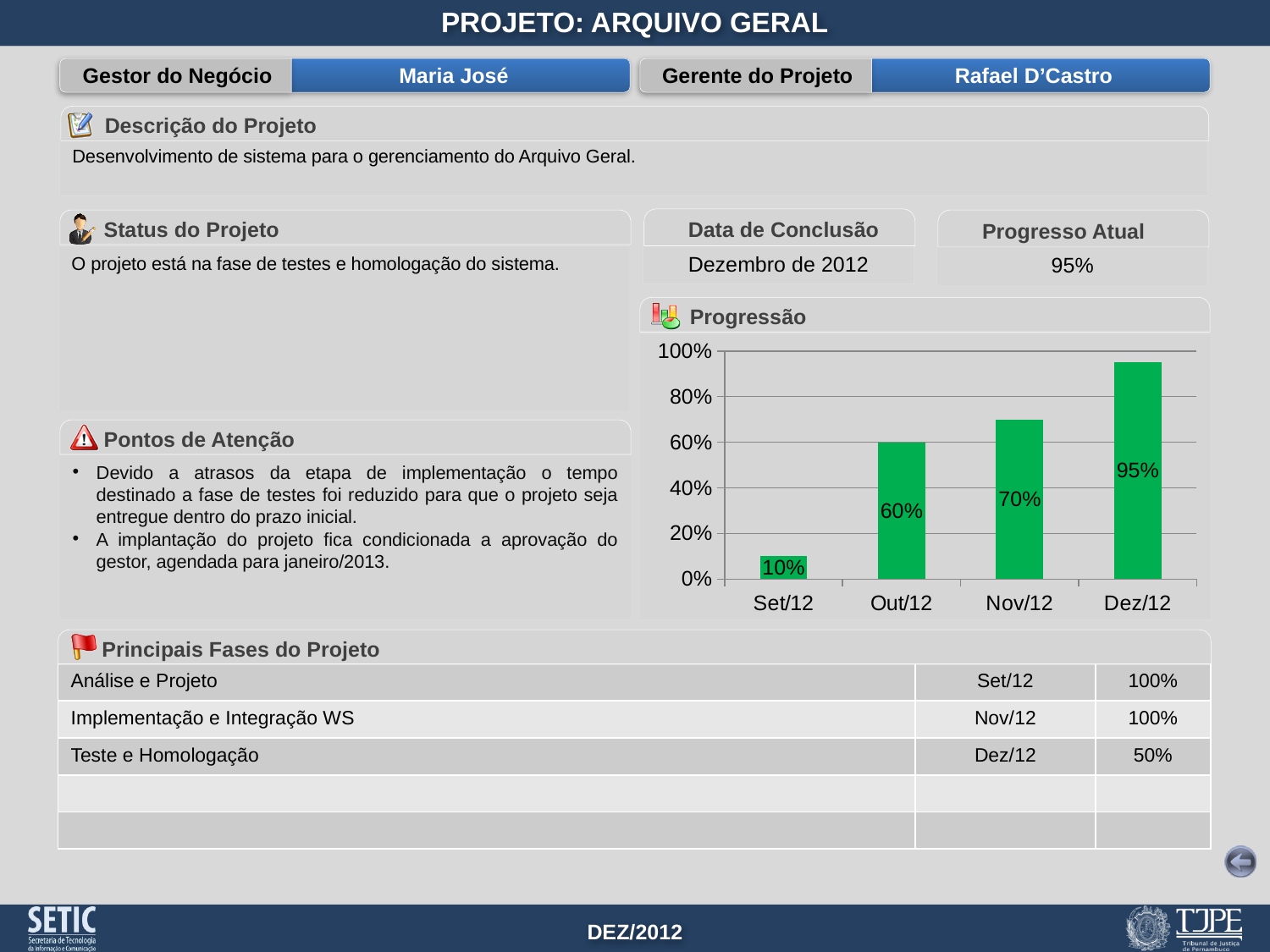
Is the value for Nov/12 in the Progressão chart greater or less than 80%? less Do the values in the Progressão chart rise or fall from Set/12 to Dez/12? rise Which month has the lowest value in the Progressão chart? Set/12 What is the difference between the values for Out/12 and Set/12 in the Progressão chart? 50% What is the value for Out/12 in the Progressão chart? 60% How many months are shown on the x axis of the Progressão chart? 4 What is the value for Dez/12 in the Progressão chart? 95% What is the difference between the values for Dez/12 and Nov/12 in the Progressão chart? 25% Which month has the highest value in the Progressão chart? Dez/12 What kind of chart is the Progressão chart? bar chart What is the value for Set/12 in the Progressão chart? 10% Which is larger in the Progressão chart, the value for Nov/12 or the value for Out/12? Nov/12